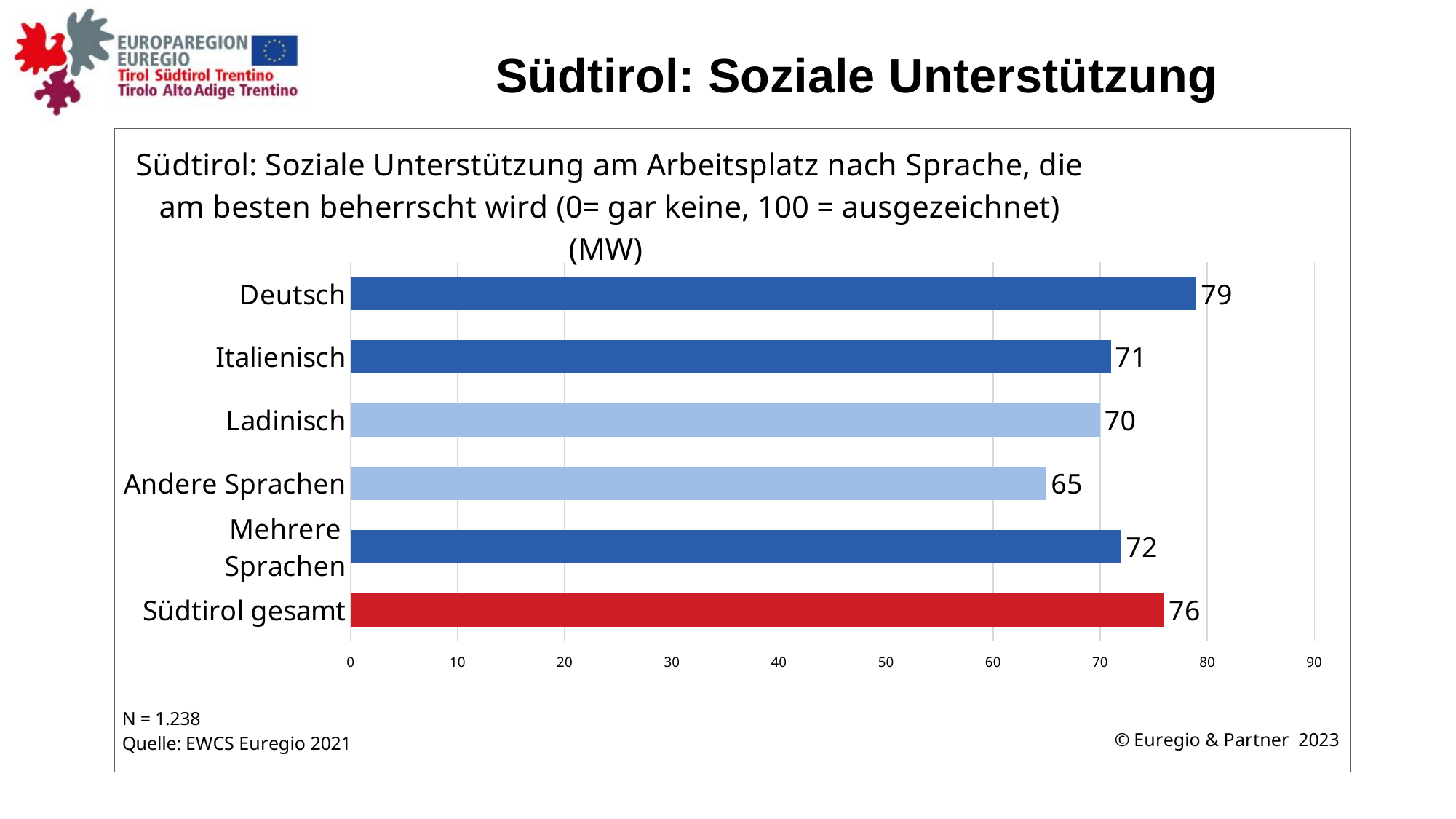
Which category's bar is coloured red? Südtirol gesamt What is the value for Mehrere Sprachen? 72 What is the sample size (N) stated below the chart? N = 1.238 What kind of chart is shown on the slide? Bar chart What is the value for Deutsch? 79 Which category has the lowest value? Andere Sprachen What is the value for Südtirol gesamt? 76 Which is larger, the value for Ladinisch or the value for Andere Sprachen? Ladinisch How many categories are shown in the chart? 6 What is the value for Andere Sprachen? 65 What is the difference between the values for Deutsch and Italienisch? 8 Which category has the highest value? Deutsch